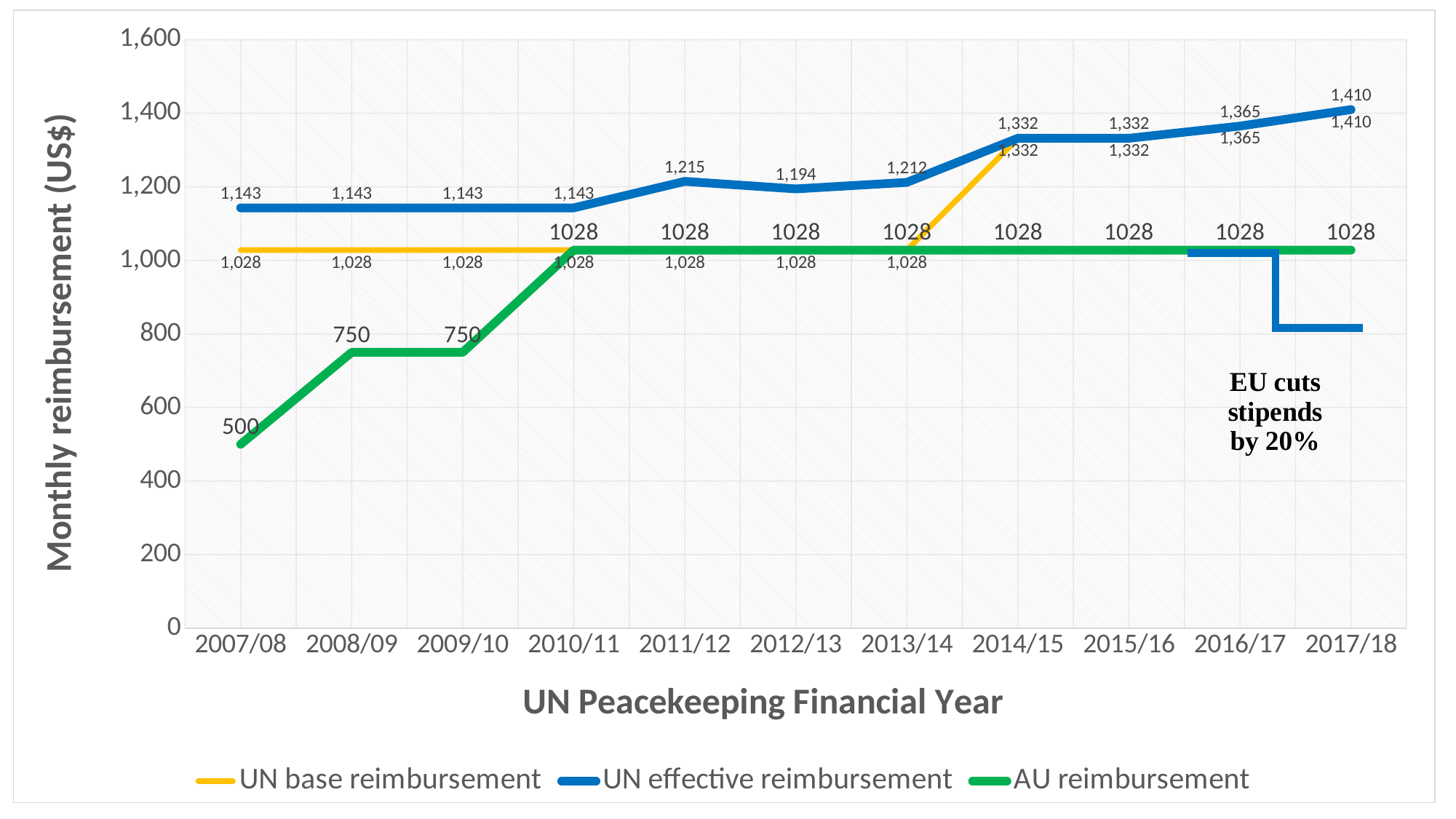
Which is larger in 2012/13, the UN effective reimbursement or the AU reimbursement? UN effective reimbursement In which financial year is the AU reimbursement lowest? 2007/08 What is the UN base reimbursement for 2009/10? 1,028 What is the AU reimbursement for 2007/08? 500 In which financial year is the UN effective reimbursement highest? 2017/18 What is the UN effective reimbursement for 2012/13? 1,194 How many series does the legend list? 3 Does the AU reimbursement rise or fall from 2007/08 to 2010/11? Rise How many financial years are shown on the x axis? 11 By how much did the UN effective reimbursement increase from 2007/08 to 2017/18? 267 What kind of chart is shown on the slide? Line chart What is the UN effective reimbursement for 2011/12? 1,215